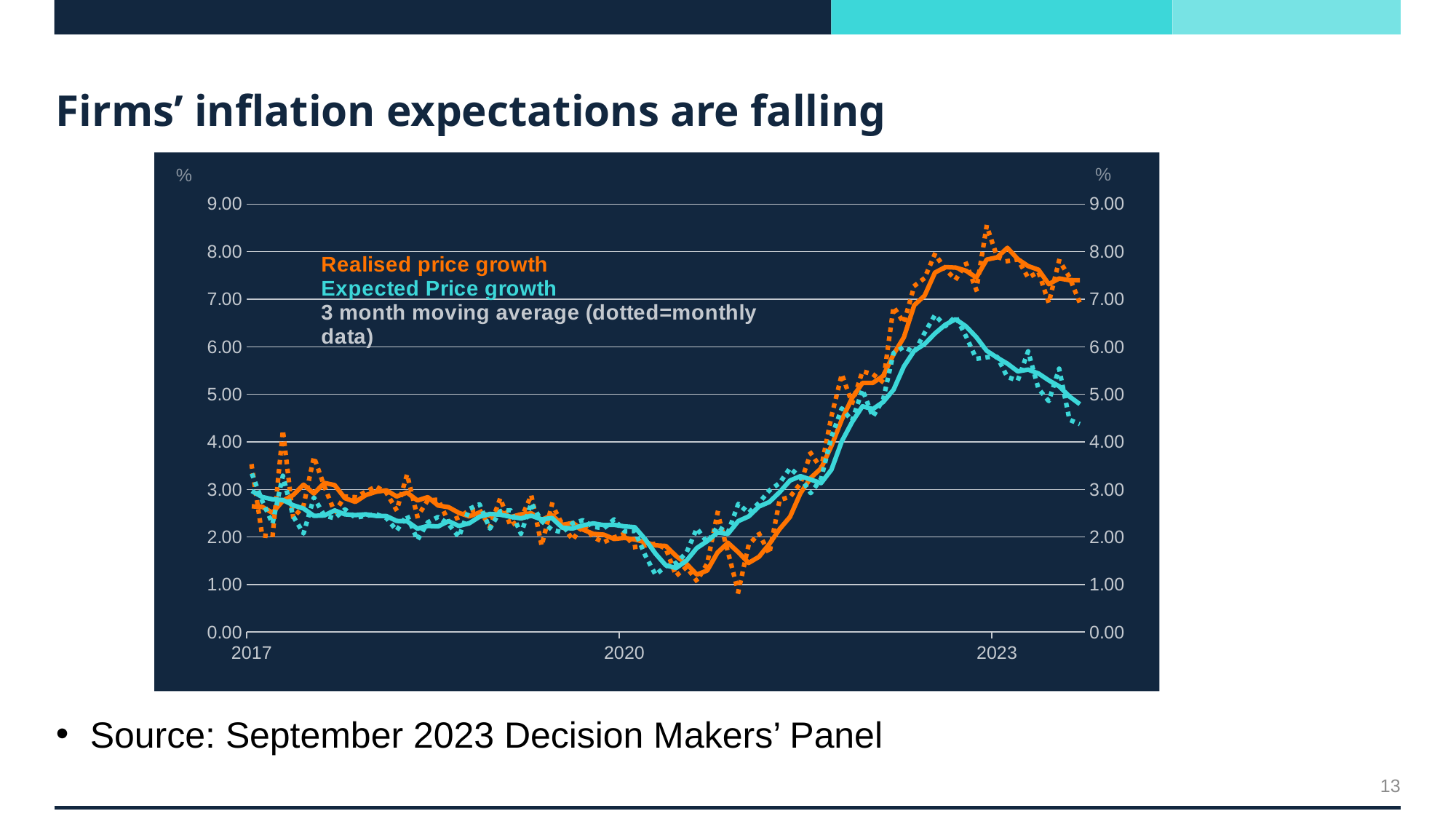
Which colour represents Expected Price growth in the chart? teal At the end of the series, which is higher: Realised price growth or Expected Price growth? Realised price growth Is the value of the Expected Price growth 3 month moving average at the end of the series greater or less than 6.00? less What is the title of the slide containing the chart? Firms' inflation expectations are falling What kind of chart is shown on the slide? line chart Is the value of the Expected Price growth 3 month moving average at its peak greater or less than 6.00? greater What is the highest value shown on the y axis? 9.00 Do the values of both series rise or fall between 2020 and 2023? rise Is the value of the Expected Price growth 3 month moving average at its peak greater or less than 7.00? less How many series does the chart's legend list? 2